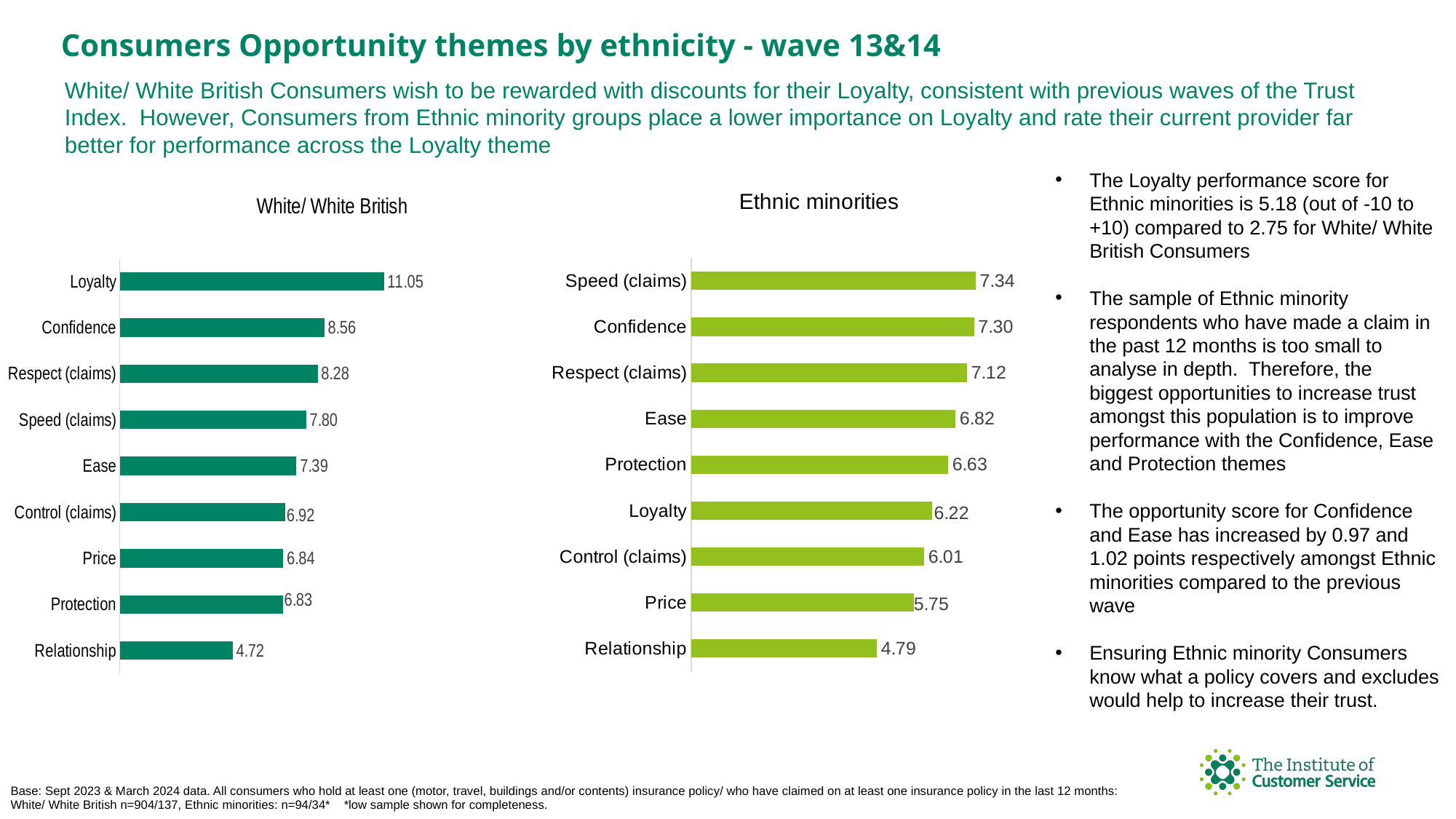
In the Ethnic minorities chart, which category has the highest value? Speed (claims) In the Ethnic minorities chart, what is the value for Protection? 6.63 Which is larger: Loyalty in the White/ White British chart or Loyalty in the Ethnic minorities chart? White/ White British In the White/ White British chart, what is the value for Loyalty? 11.05 In the White/ White British chart, what is the difference between Loyalty and Confidence? 2.49 How many categories are shown in the White/ White British chart? 9 What type of chart is the Ethnic minorities chart? Bar chart In the White/ White British chart, which category has the lowest value? Relationship In the White/ White British chart, what is the value for Control (claims)? 6.92 What is the title of the chart on the left? White/ White British In the Ethnic minorities chart, which is larger: Ease or Price? Ease In the Ethnic minorities chart, what is the difference between Speed (claims) and Relationship? 2.55